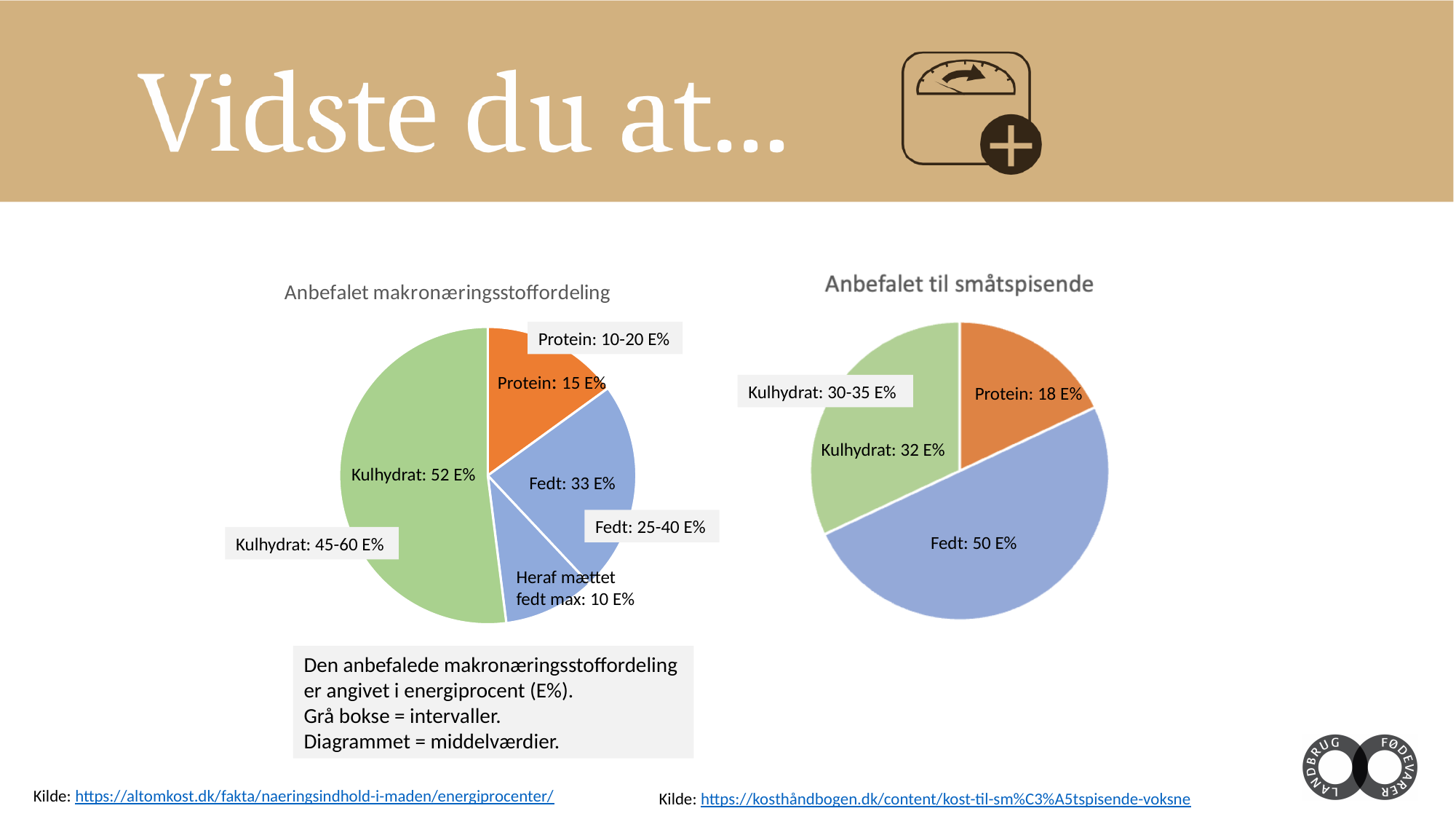
In the "Anbefalet makronæringsstoffordeling" chart, what is the value for Protein? 15 E% In the "Anbefalet makronæringsstoffordeling" chart, what is the difference between Kulhydrat and Fedt? 19 E% In the "Anbefalet til småtspisende" chart, which category has the largest slice? Fedt In the "Anbefalet til småtspisende" chart, what is the difference between Fedt and Kulhydrat? 18 E% In the "Anbefalet makronæringsstoffordeling" chart, which category has the largest slice? Kulhydrat In the "Anbefalet til småtspisende" chart, what is the value for Fedt? 50 E% In the "Anbefalet til småtspisende" chart, which is larger, Kulhydrat or Protein? Kulhydrat In the "Anbefalet til småtspisende" chart, what is the value for Protein? 18 E% What kind of chart is "Anbefalet makronæringsstoffordeling"? pie chart In the "Anbefalet makronæringsstoffordeling" chart, what is the value for Fedt? 33 E% In the "Anbefalet makronæringsstoffordeling" chart, what is the value for Kulhydrat? 52 E%